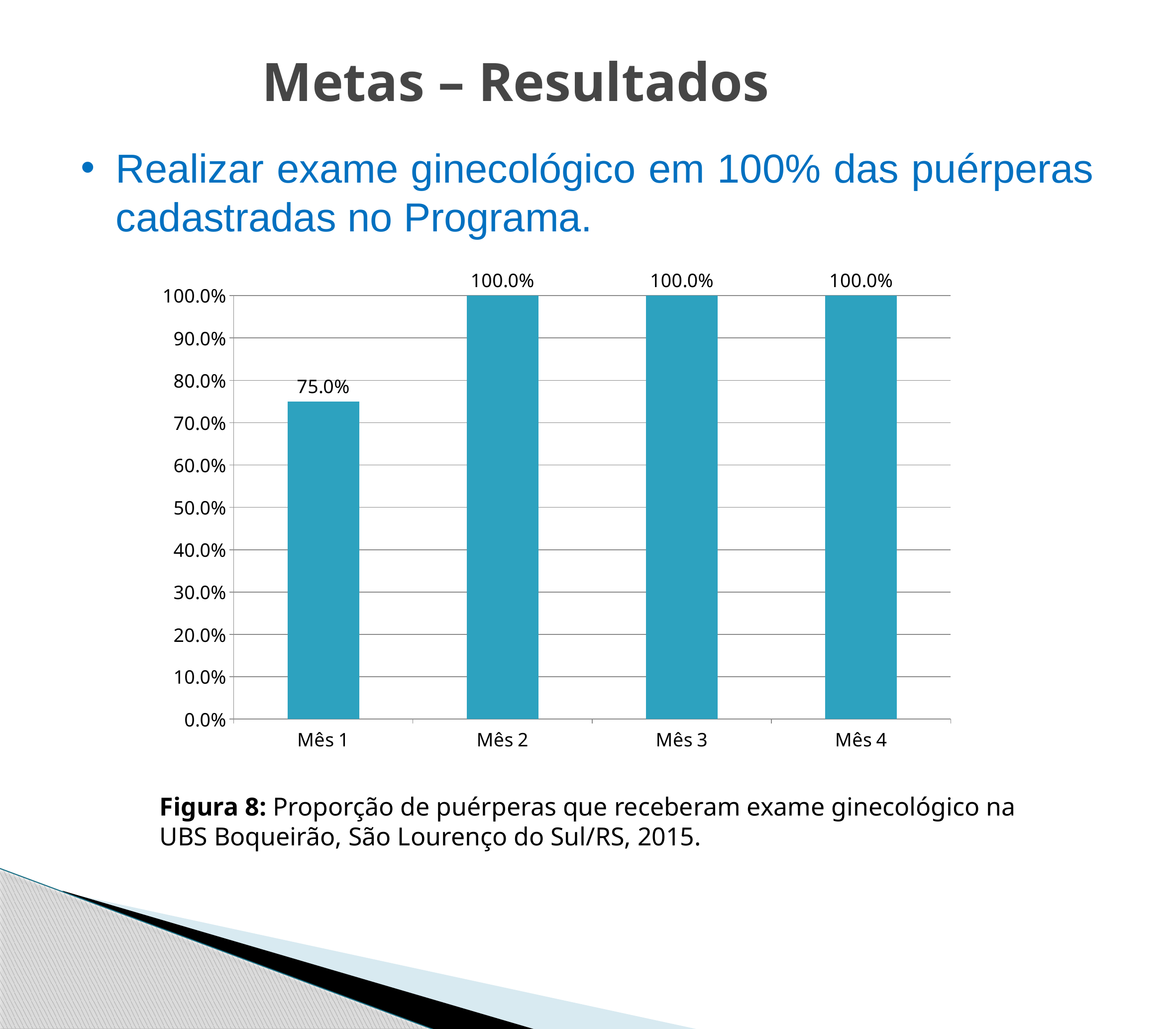
Which month has the lowest value? Mês 1 What is the value for Mês 1? 75.0% What is the figure number given in the caption below the chart? Figura 8 What kind of chart is shown on the slide? bar chart How many months are shown on the x axis? 4 Is the value for Mês 1 greater or less than 80.0%? less What is the value for Mês 4? 100.0% What is the value for Mês 2? 100.0% Do the values rise or fall from Mês 1 to Mês 2? rise What is the difference between the values for Mês 2 and Mês 1? 25.0% How many months have a value of 100.0%? 3 Which is larger, the value for Mês 1 or the value for Mês 3? Mês 3